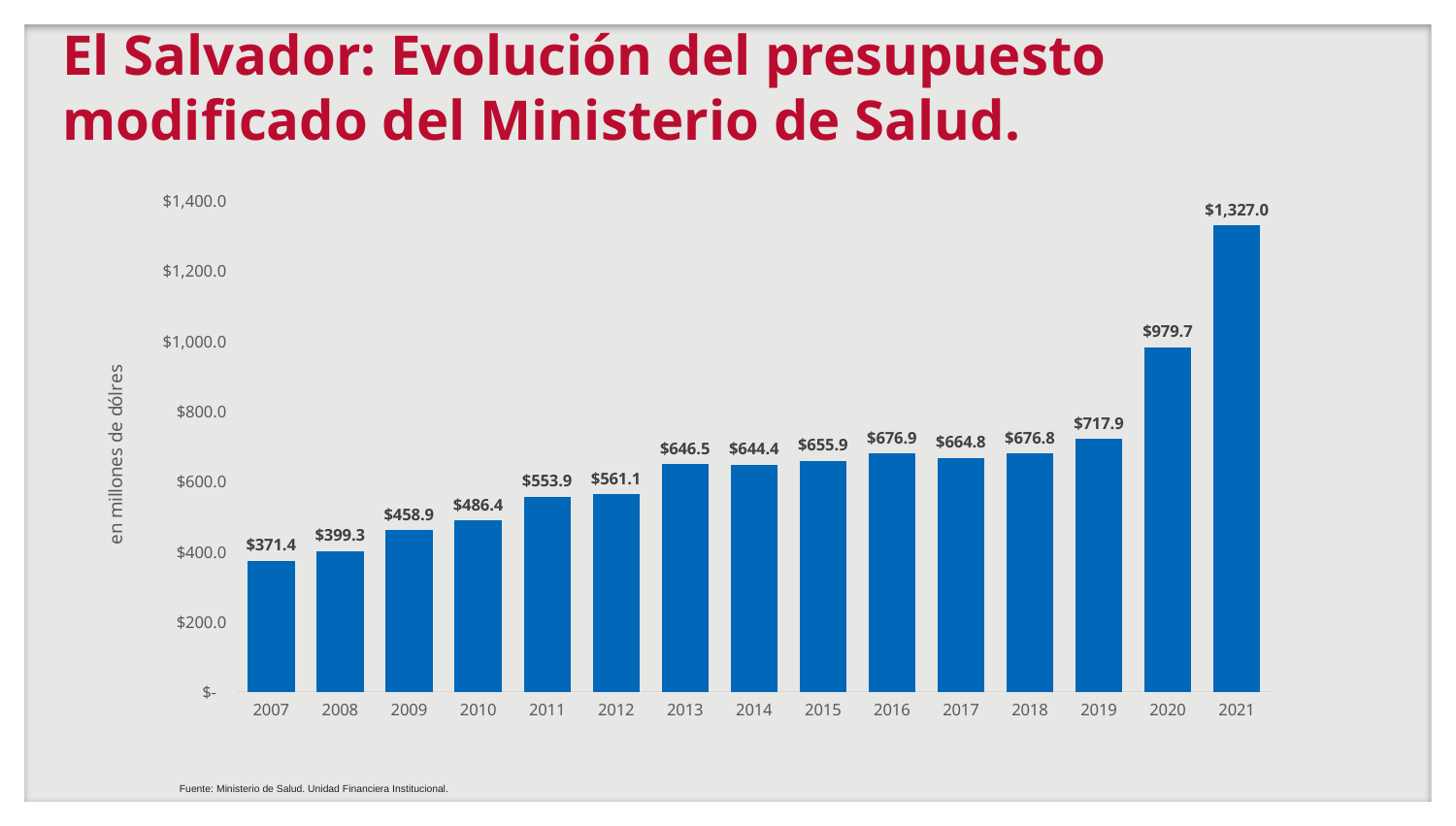
Is the value for 2013 greater or less than $600.0? greater Which is larger, the value for 2020 or the value for 2019? 2020 What is the difference between the values for 2021 and 2020? $347.3 What is the value for 2007? $371.4 Which year has the highest value? 2021 What is the value for 2014? $644.4 What is the value for 2021? $1,327.0 What is the label of the vertical axis? en millones de dólres What is the difference between the values for 2019 and 2018? $41.1 Which year has the lowest value? 2007 What kind of chart is shown on the slide? Bar chart How many years are shown on the x axis? 15